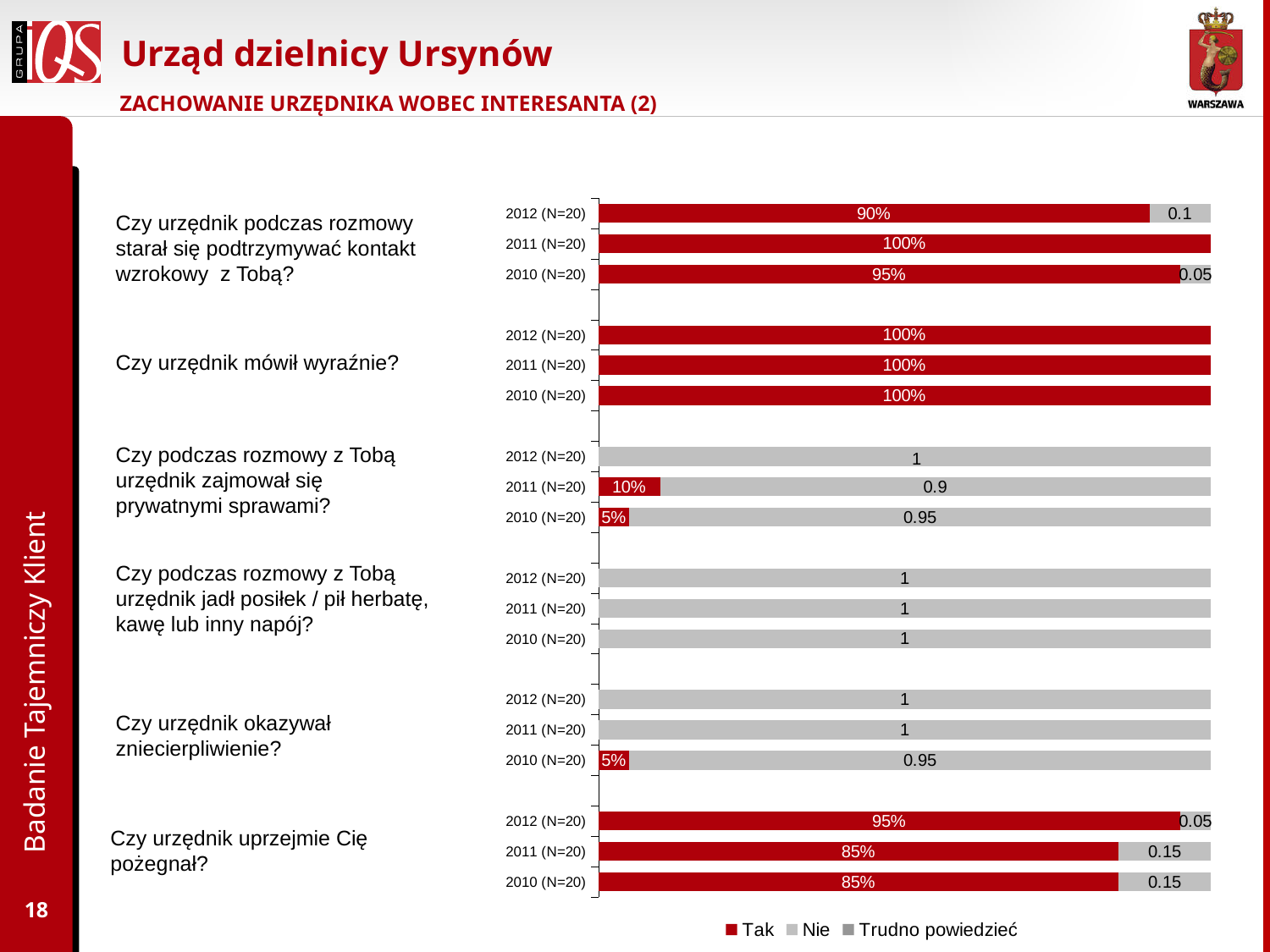
What is the 'Tak' value for 2011 (N=20) for the question 'Czy urzędnik mówił wyraźnie?' 100% What kind of chart is shown on the slide? bar chart For the question 'Czy urzędnik podczas rozmowy starał się podtrzymywać kontakt wzrokowy z Tobą?', which is larger: the 'Tak' value for 2011 (N=20) or for 2012 (N=20)? 2011 (N=20) What is the 'Tak' value for 2011 (N=20) for the question 'Czy podczas rozmowy z Tobą urzędnik zajmował się prywatnymi sprawami?' 10% What are the series names listed in the chart legend? Tak, Nie, Trudno powiedzieć What is the 'Tak' value for 2011 (N=20) for the question 'Czy urzędnik uprzejmie Cię pożegnał?' 85% What is the 'Tak' value for 2012 (N=20) for the question 'Czy urzędnik podczas rozmowy starał się podtrzymywać kontakt wzrokowy z Tobą?' 90% For the question 'Czy urzędnik uprzejmie Cię pożegnał?', which year has the highest 'Tak' value? 2012 (N=20) How many series does the chart legend list? 3 For the question 'Czy urzędnik uprzejmie Cię pożegnał?', what is the difference between the 'Tak' values for 2012 (N=20) and 2011 (N=20)? 10% What is the 'Nie' value for 2010 (N=20) for the question 'Czy urzędnik okazywał zniecierpliwienie?' 0.95 What is the 'Nie' value for 2012 (N=20) for the question 'Czy urzędnik podczas rozmowy starał się podtrzymywać kontakt wzrokowy z Tobą?' 0.1